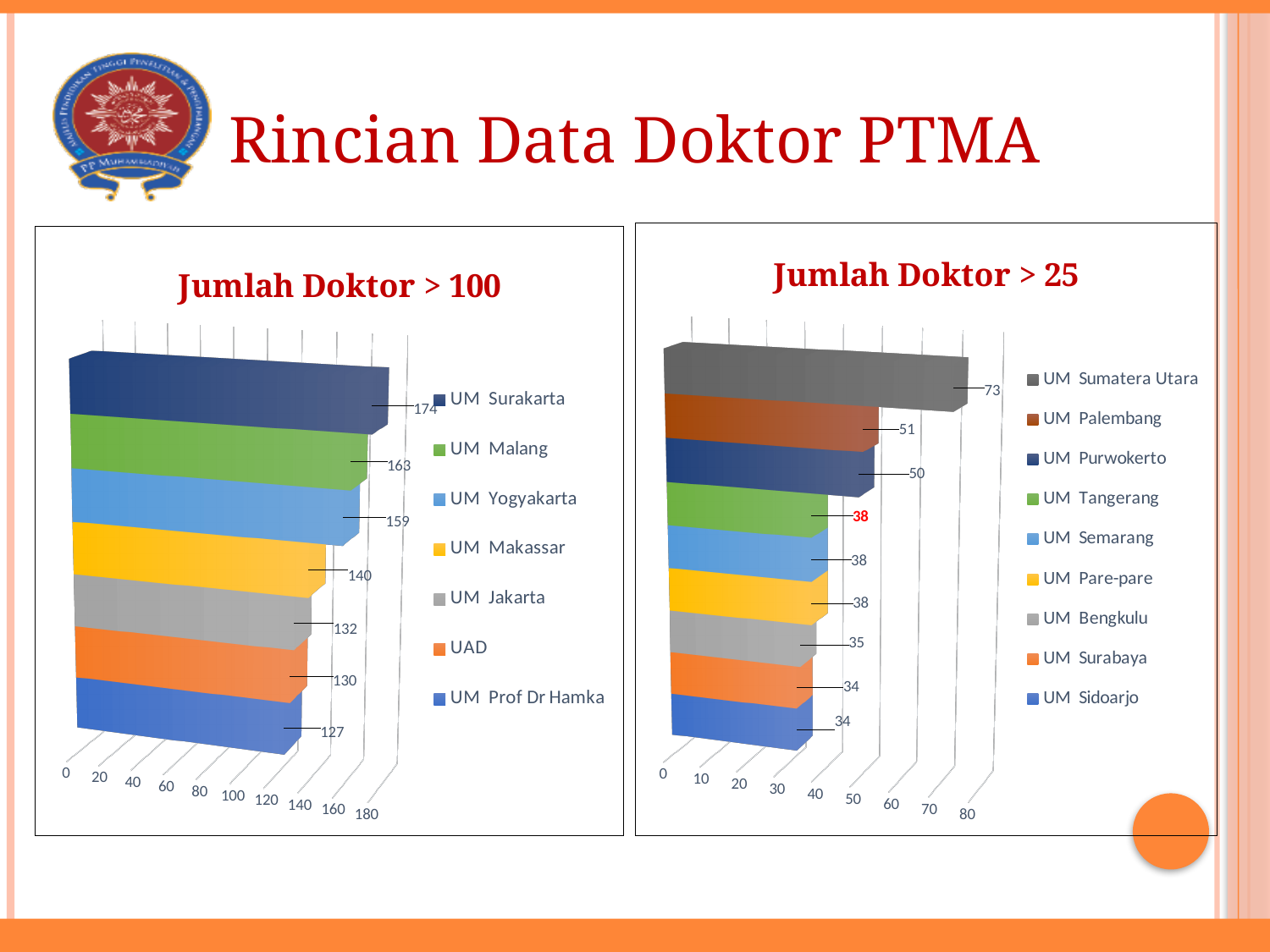
In the 'Jumlah Doktor > 25' chart, what is the difference between UM Sumatera Utara and UM Palembang? 22 In the 'Jumlah Doktor > 100' chart, which category has the lowest value? UM Prof Dr Hamka In the 'Jumlah Doktor > 100' chart, which is larger, UM Jakarta or UAD? UM Jakarta What type of chart is the 'Jumlah Doktor > 25' chart? Bar chart In the 'Jumlah Doktor > 25' chart, what is the value for UM Bengkulu? 35 How many categories are shown in the 'Jumlah Doktor > 100' chart? 7 In the 'Jumlah Doktor > 100' chart, what is the value for UM Makassar? 140 In the 'Jumlah Doktor > 100' chart, what is the value for UM Surakarta? 174 In the 'Jumlah Doktor > 100' chart, what is the difference between UM Malang and UM Yogyakarta? 4 In the 'Jumlah Doktor > 25' chart, which category has the highest value? UM Sumatera Utara In the 'Jumlah Doktor > 25' chart, what is the value for UM Sumatera Utara? 73 How many entries does the legend of the 'Jumlah Doktor > 25' chart list? 9